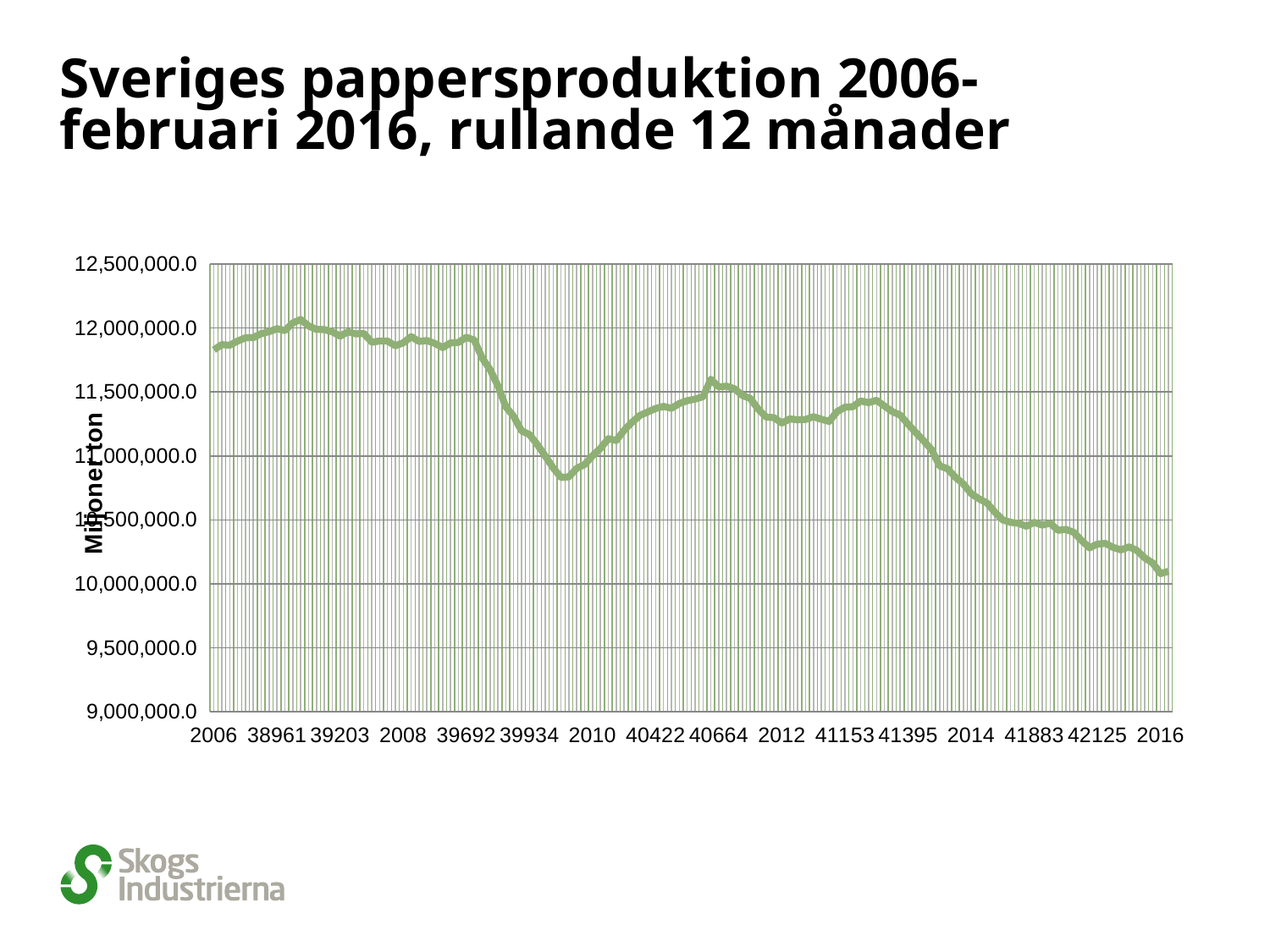
Overall, do the values rise or fall from 2006 to 2016 along the x axis? fall Is the value at 2012 greater or less than 11,000,000.0? greater Is the value at 2014 greater or less than 11,000,000.0? less Is the value at 2016 greater or less than 10,500,000.0? less What kind of chart is shown on the slide? line chart Which is larger, the value at 2012 or the value at 2014? 2012 Which is larger, the value at 2006 or the value at 2016? 2006 At which x-axis label is the plotted value lowest? 2016 What is the title of the chart on the slide? Sveriges pappersproduktion 2006-februari 2016, rullande 12 månader What is the label on the vertical axis of the chart? Miljoner ton